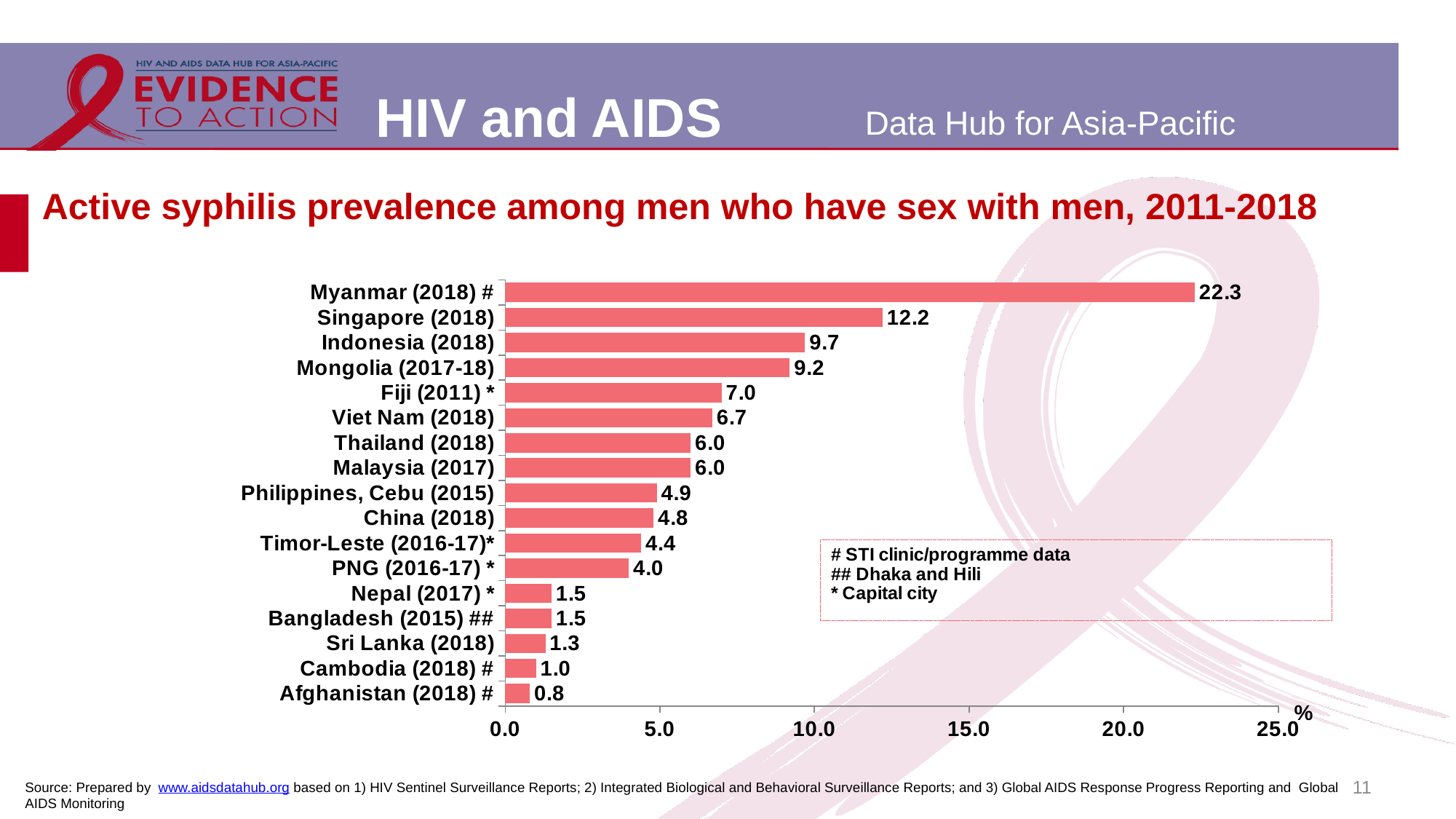
Is the value for Indonesia (2018) greater or less than 10.0? less What is the value shown for Sri Lanka (2018)? 1.3 What is the value shown for Singapore (2018)? 12.2 What is the difference between the values for Indonesia (2018) and Mongolia (2017-18)? 0.5 How many countries or locations are shown in the chart? 17 What type of chart is shown on the slide? Bar chart What is the value shown for Viet Nam (2018)? 6.7 Which has a larger value, Fiji (2011) * or China (2018)? Fiji (2011) * Which country has the highest active syphilis prevalence in the chart? Myanmar (2018) # What is the difference between the values for Myanmar (2018) # and Singapore (2018)? 10.1 What is the active syphilis prevalence value shown for Myanmar (2018) #? 22.3 Which country has the lowest active syphilis prevalence in the chart? Afghanistan (2018) #